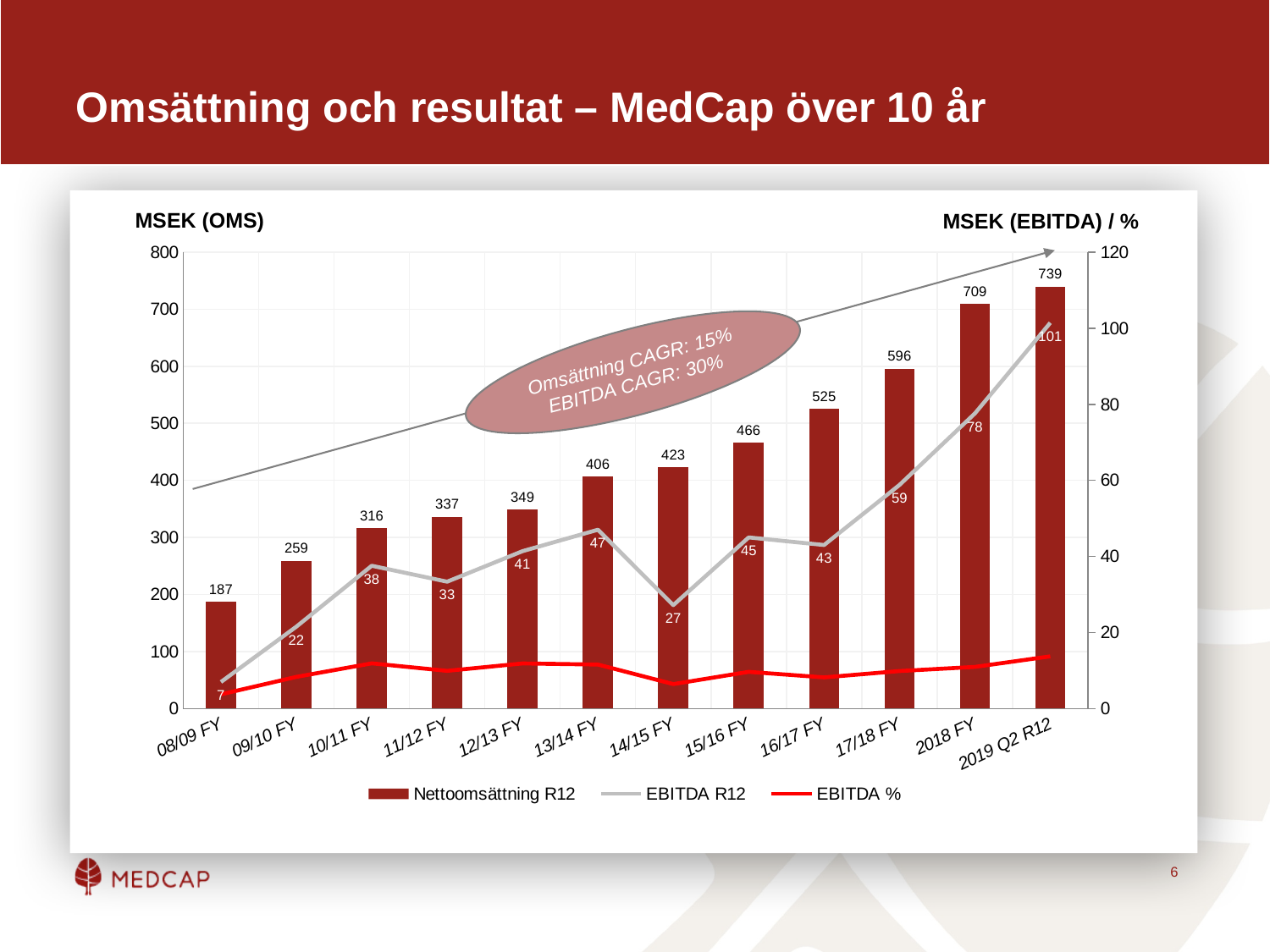
Do the Nettoomsättning R12 values rise or fall from 08/09 FY to 2019 Q2 R12? rise What is the Nettoomsättning R12 value for 2018 FY? 709 How many series does the legend list? 3 Is the Nettoomsättning R12 value for 16/17 FY greater or less than 500? greater Which period has the lowest EBITDA R12 value? 08/09 FY Which period has the highest Nettoomsättning R12 value? 2019 Q2 R12 What Omsättning CAGR is stated in the callout on the chart? 15% How many periods are shown on the x axis? 12 What kind of chart is used for the Nettoomsättning R12 series? bar chart Which is larger, the EBITDA R12 value for 13/14 FY or for 14/15 FY? 13/14 FY What is the EBITDA R12 value for 17/18 FY? 59 What is the difference in Nettoomsättning R12 between 2019 Q2 R12 and 2018 FY? 30